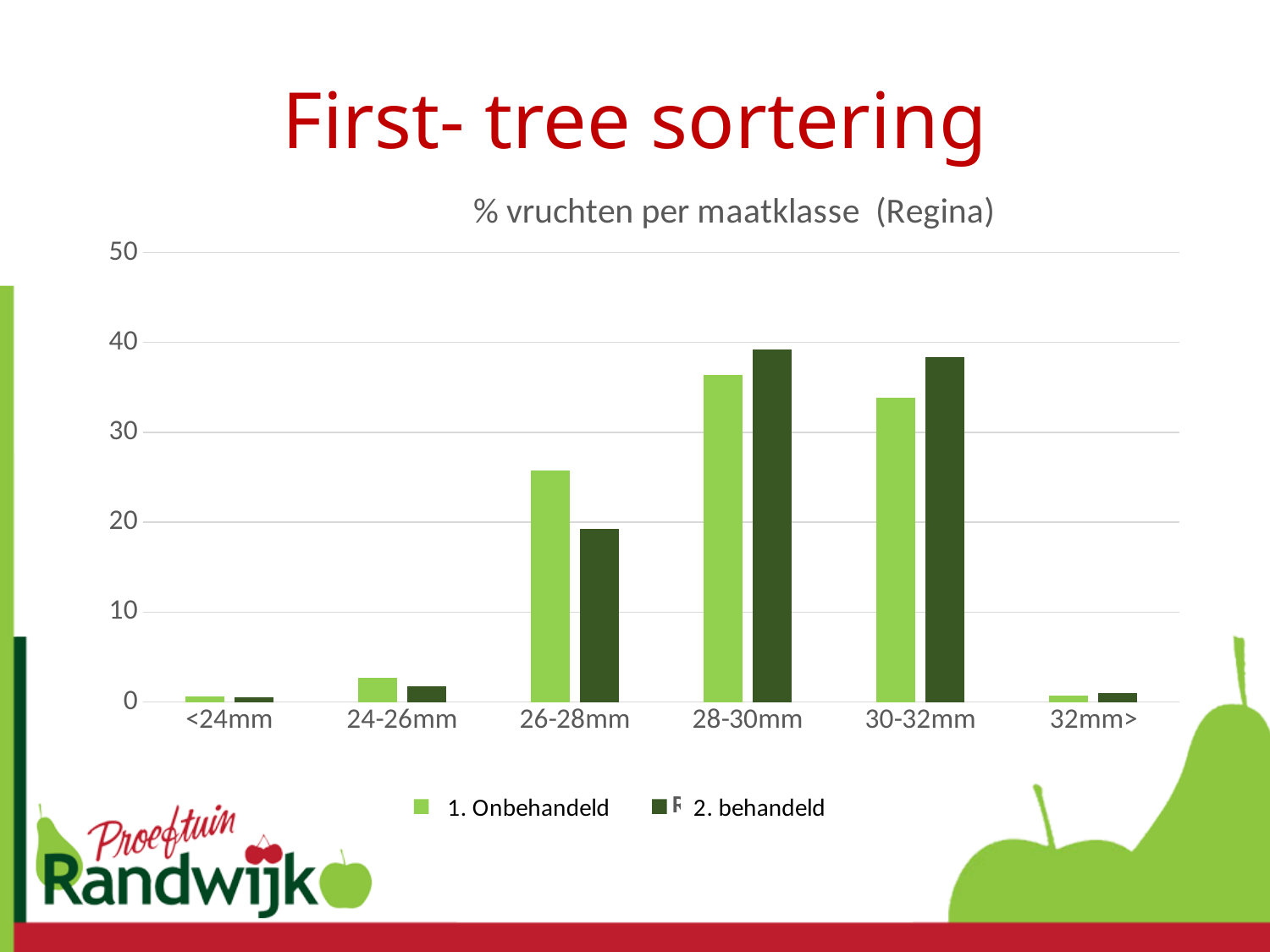
What is the title of the chart? % vruchten per maatklasse (Regina) How many series does the legend list? 2 Is the value for 1. Onbehandeld in the 30-32mm class greater or less than 30? greater Is the value for 2. behandeld in the 28-30mm class greater or less than 40? less For the 28-30mm class, which series has the larger value, 1. Onbehandeld or 2. behandeld? 2. behandeld For the 30-32mm class, which series has the larger value, 1. Onbehandeld or 2. behandeld? 2. behandeld How many size classes are shown on the x axis? 6 For the 26-28mm class, which series has the larger value, 1. Onbehandeld or 2. behandeld? 1. Onbehandeld Which size class has the highest value for 1. Onbehandeld? 28-30mm Is the value for 1. Onbehandeld in the 26-28mm class greater or less than 20? greater What kind of chart is shown on the slide? bar chart